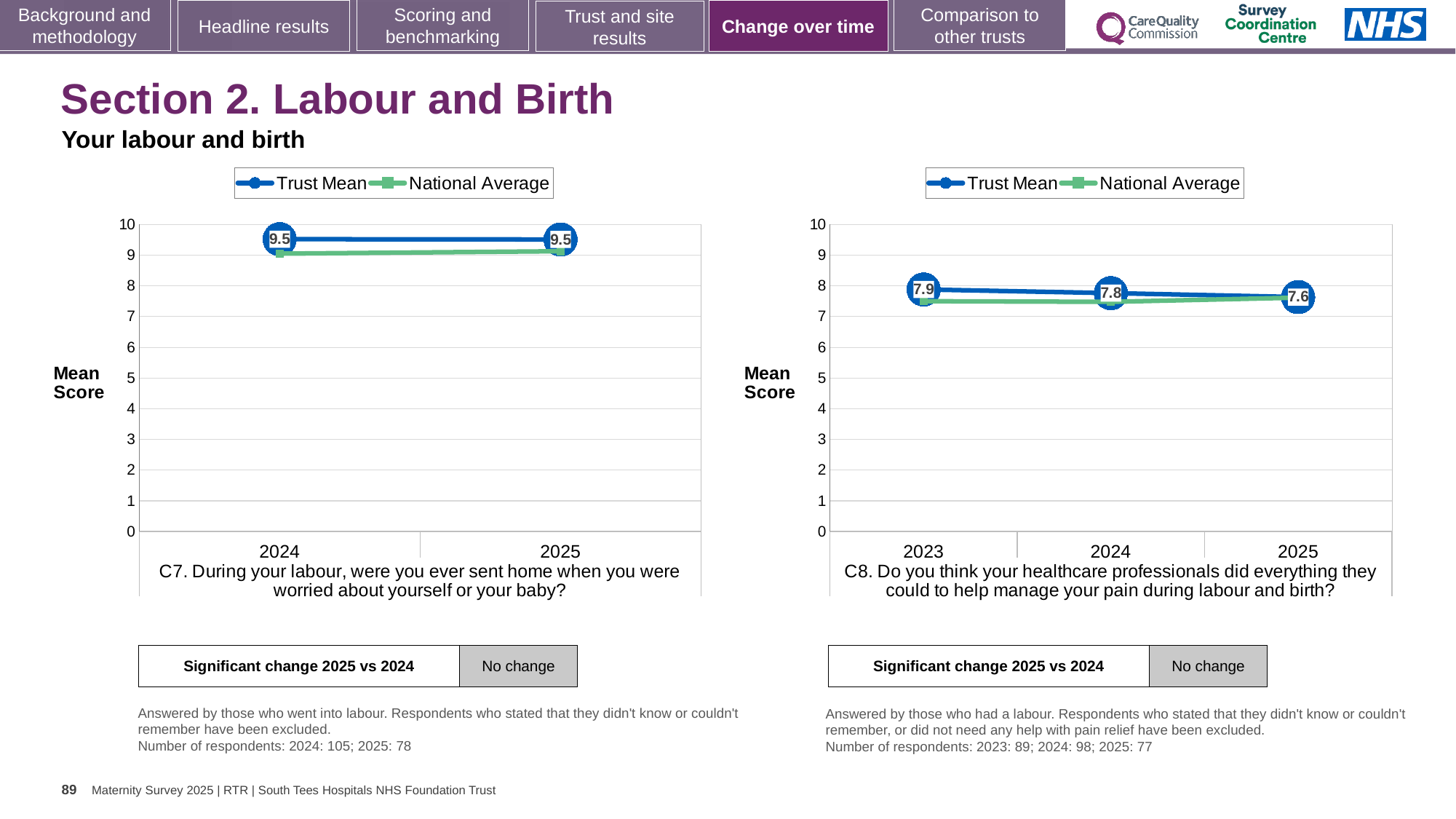
In the left chart (C7), what is the Trust Mean score for 2025? 9.5 In the right chart (C8), does the Trust Mean rise or fall from 2023 to 2025? fall In the right chart (C8), is the Trust Mean for 2024 larger or smaller than the Trust Mean for 2025? larger In the right chart (C8), which year has the highest Trust Mean score? 2023 In the left chart (C7), is the National Average value for 2024 greater or less than 8? greater In the right chart (C8), what is the Trust Mean score for 2023? 7.9 In the right chart (C8), what is the difference between the Trust Mean scores for 2023 and 2025? 0.3 How many series does the legend of the left chart (C7) list? 2 In the left chart (C7), what is the Trust Mean score for 2024? 9.5 In the right chart (C8), what is the Trust Mean score for 2025? 7.6 How many years are shown on the x axis of the right chart (C8)? 3 What kind of chart is the left chart (C7)? line chart